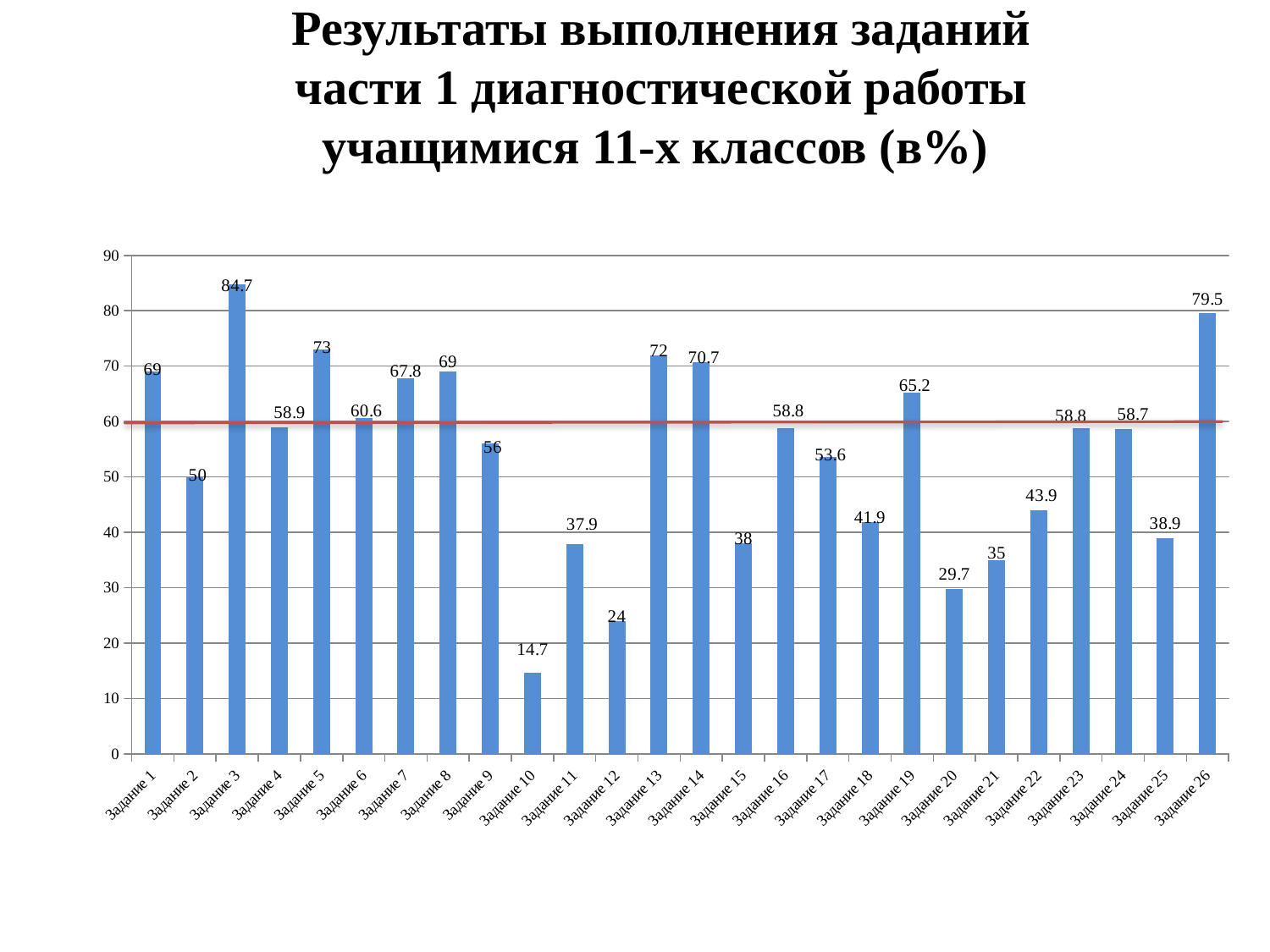
Which task (Задание) has the highest value? Задание 3 What is the value for Задание 19? 65.2 Which task (Задание) has the lowest value? Задание 10 At what value on the y axis is the red horizontal line drawn? 60 What is the difference between the values for Задание 26 and Задание 12? 55.5 Is the value for Задание 20 greater or less than 30? less How many tasks (categories) are shown on the x axis? 26 What kind of chart is shown on the slide? bar chart Which is larger, the value for Задание 5 or the value for Задание 14? Задание 5 What is the value for Задание 10? 14.7 What is the difference between the values for Задание 3 and Задание 10? 70 What is the value for Задание 3? 84.7